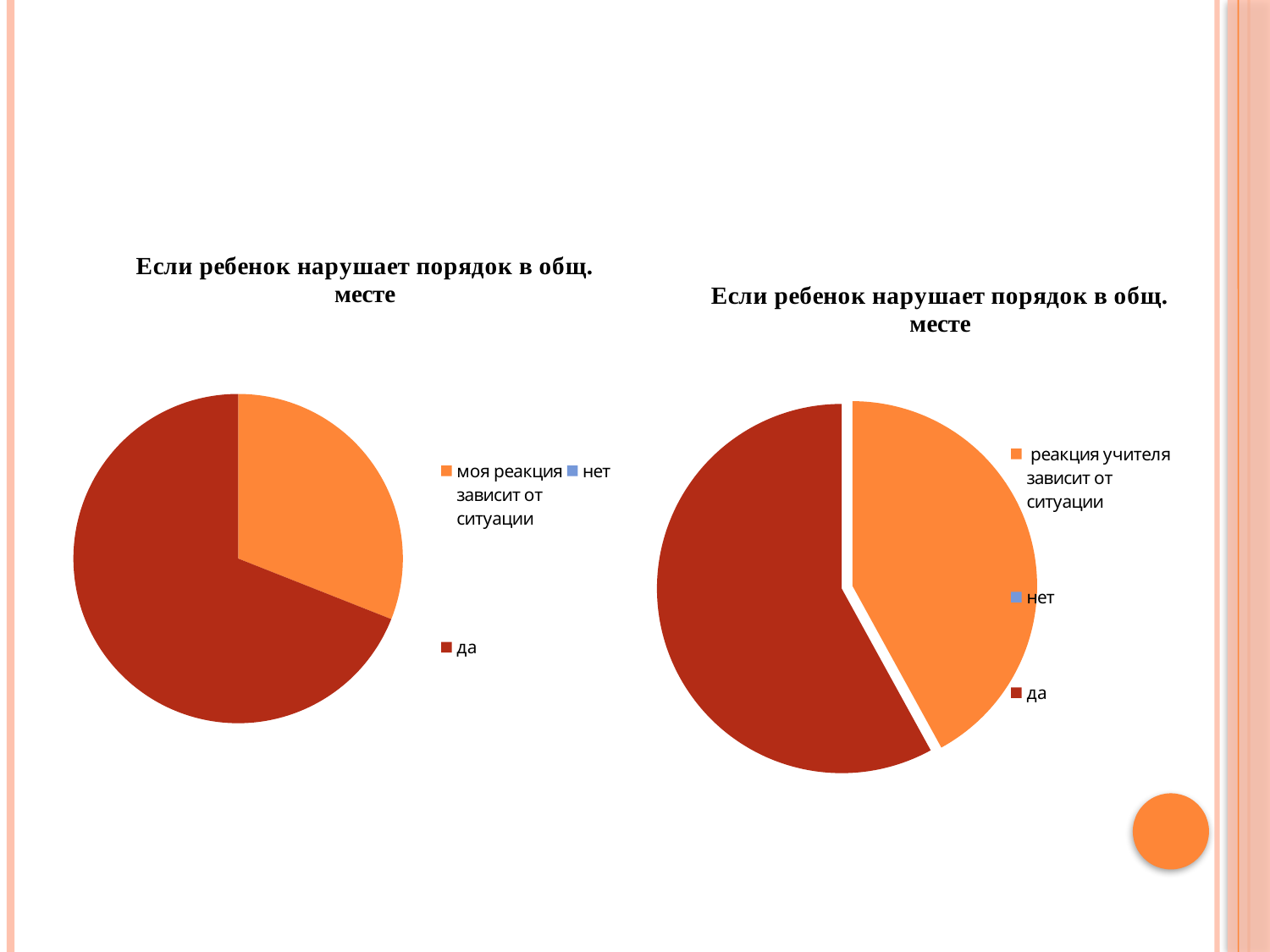
What kind of chart is the left chart on the slide? pie chart In the left pie chart, which category has the largest slice? да How many entries does the legend of the left pie chart list? 3 What is the title of the left pie chart? Если ребенок нарушает порядок в общ. месте In the right pie chart, which slice is larger: "да" or "реакция учителя зависит от ситуации"? да In the right pie chart, which category has the largest slice? да In the right pie chart, what colour is the "да" slice? dark red How many entries does the legend of the right pie chart list? 3 In the left pie chart, which slice is larger: "да" or "моя реакция зависит от ситуации"? да What kind of chart is the right chart on the slide? pie chart